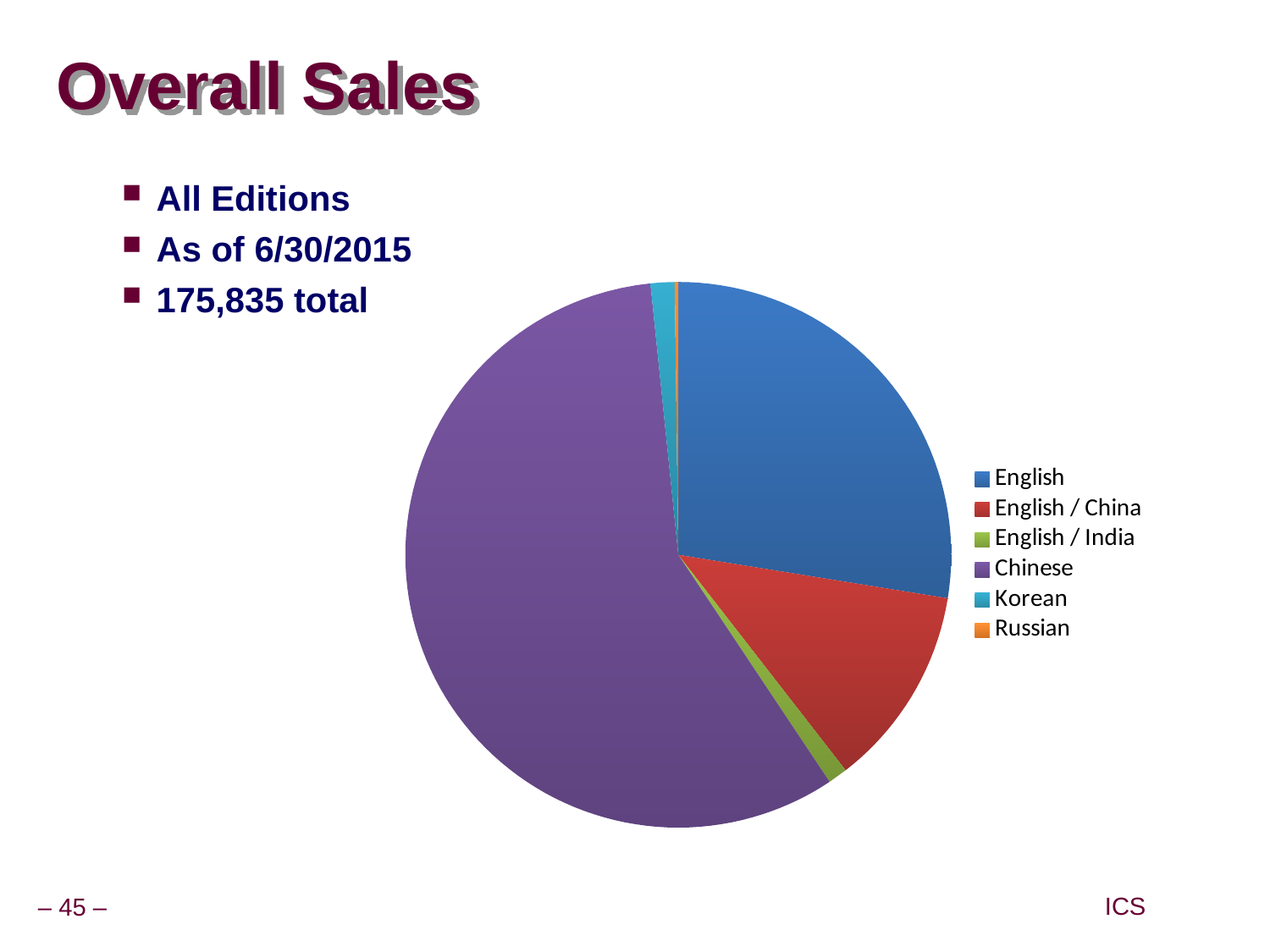
How many entries does the legend list? 6 What colour is the Chinese slice of the pie? purple Which slice is larger, English / China or English / India? English / China Which slice is larger, Chinese or English? Chinese Which legend entry is shown in blue? English How many categories does the pie chart have? 6 Which category has the largest slice of the pie? Chinese What kind of chart is shown on the slide? pie chart Which slice is larger, English or English / China? English Which category has the smallest slice of the pie? Russian